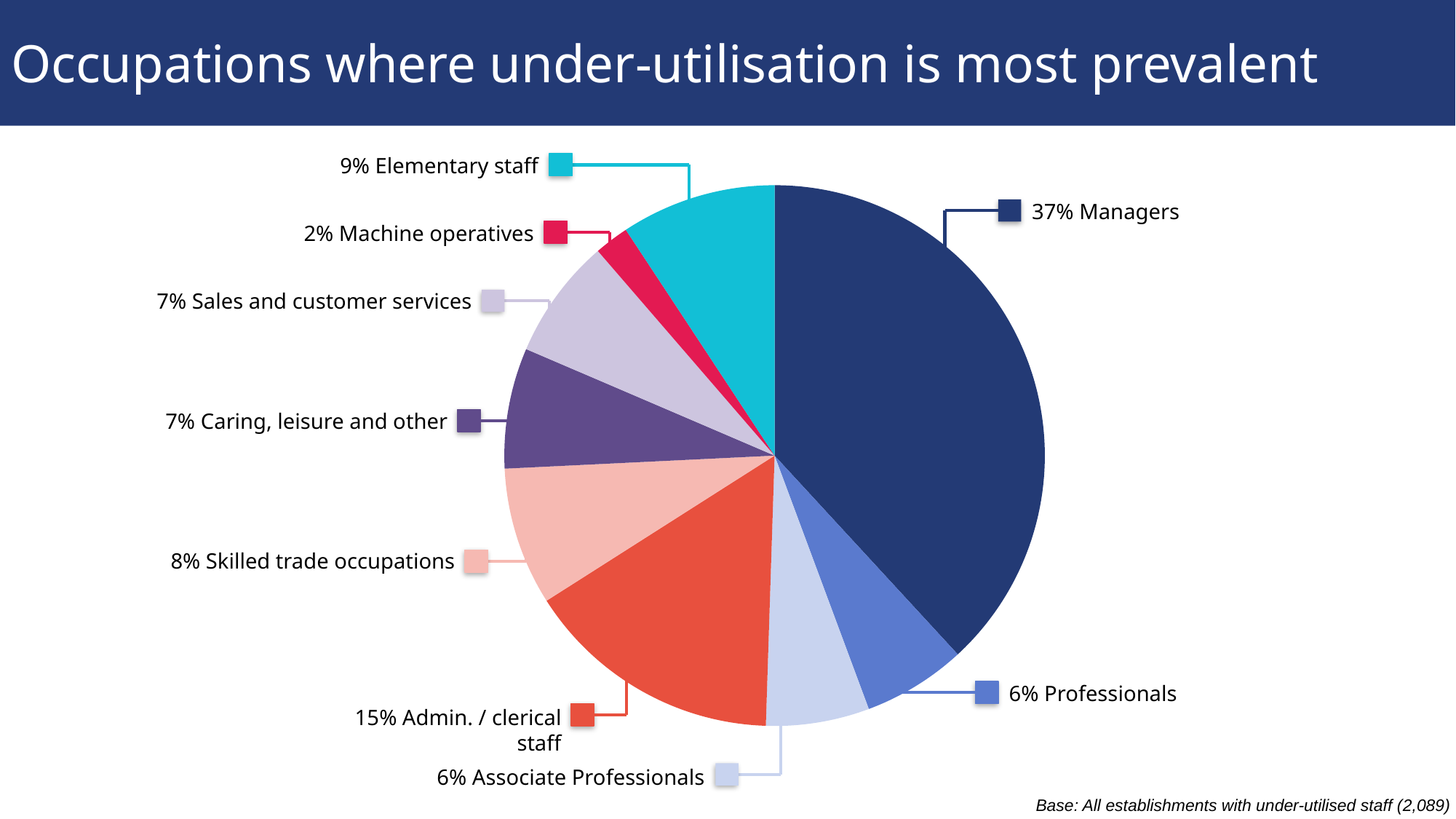
What is the base stated for the chart? All establishments with under-utilised staff (2,089) What is the value for Admin. / clerical staff? 15% What is the value for Professionals? 6% How many occupation categories are shown in the pie chart? 9 Which is larger, Skilled trade occupations or Sales and customer services? Skilled trade occupations What is the title of the slide? Occupations where under-utilisation is most prevalent What share of the pie is Managers? 37% What is the value for Elementary staff? 9% What kind of chart is shown on the slide? Pie chart Which occupation has the smallest slice of the pie? Machine operatives Which occupation has the largest slice of the pie? Managers What is the difference between the Managers share and the Admin. / clerical staff share? 22%